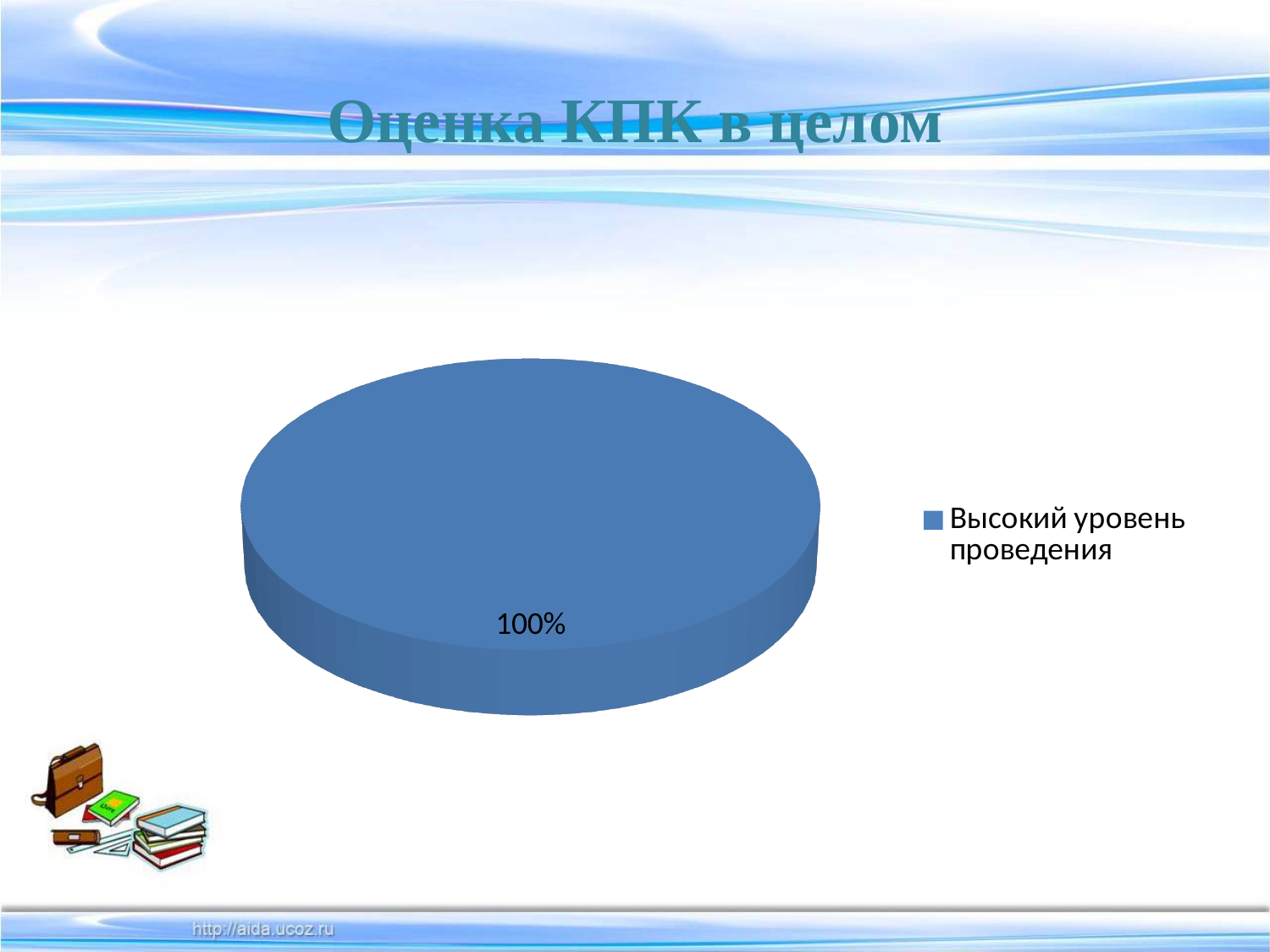
What is the legend entry for the pie chart? Высокий уровень проведения What value is printed on the pie slice? 100% What is the title of the slide containing the pie chart? Оценка КПК в целом How many slices does the pie chart have? 1 How many entries does the legend list? 1 What share of the pie does "Высокий уровень проведения" take? 100% What kind of chart is shown on the slide? pie chart